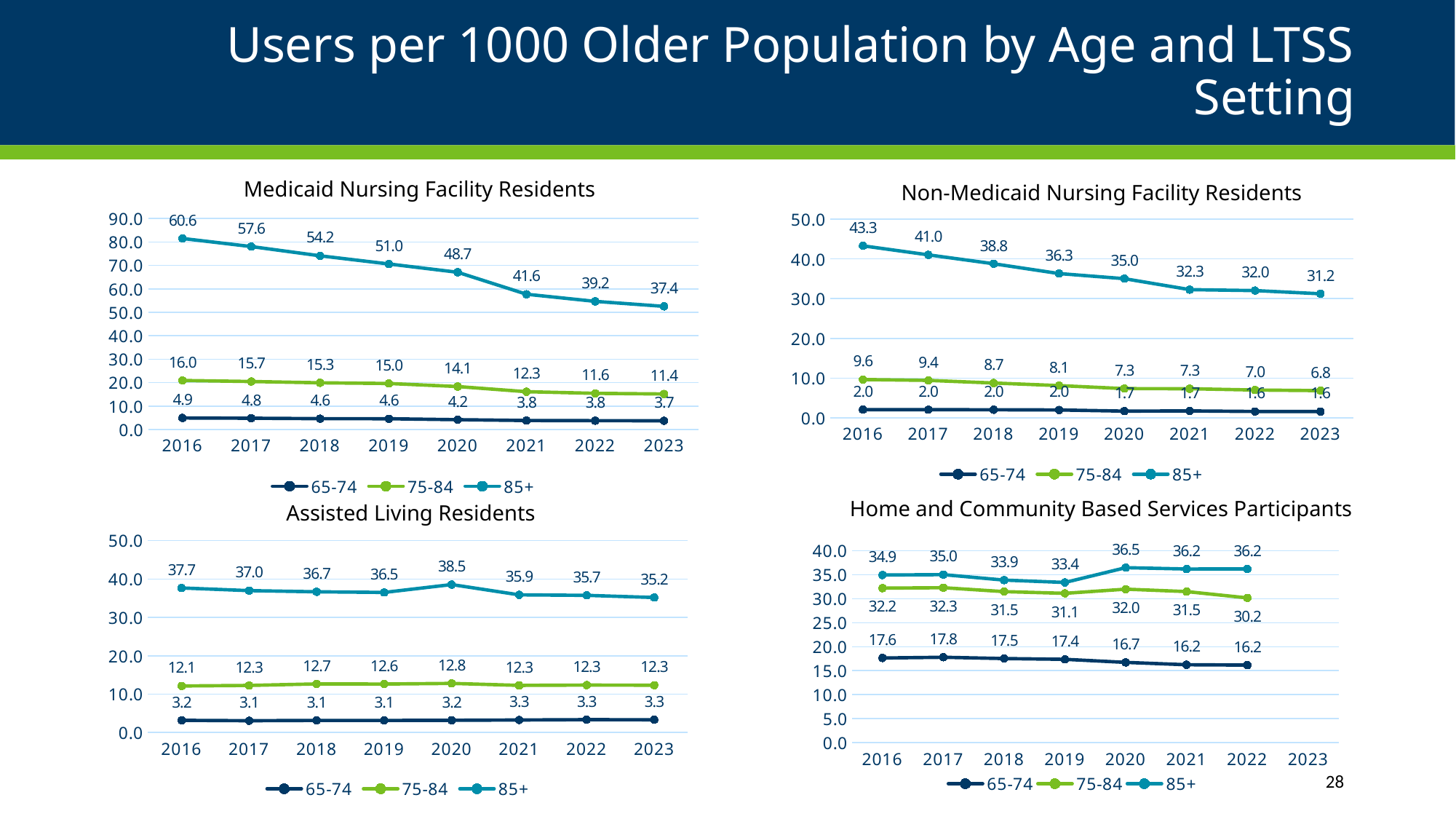
How many series does the legend list in the Assisted Living Residents chart? 3 What kind of chart is the Home and Community Based Services Participants chart? line chart In the Non-Medicaid Nursing Facility Residents chart, does the 85+ series rise or fall from 2016 to 2023? fall In the Medicaid Nursing Facility Residents chart, what is the value for the 85+ series in 2016? 60.6 In the Assisted Living Residents chart, what is the value for the 75-84 series in 2020? 12.8 In the Non-Medicaid Nursing Facility Residents chart, in which year is the 85+ series lowest? 2023 In the Assisted Living Residents chart, in which year is the 85+ series highest? 2020 In the Home and Community Based Services Participants chart, which is larger in 2022: the 85+ value or the 75-84 value? 85+ In the Medicaid Nursing Facility Residents chart, what is the difference between the 85+ values in 2016 and 2023? 23.2 In the Home and Community Based Services Participants chart, what is the value for the 65-74 series in 2017? 17.8 In the Non-Medicaid Nursing Facility Residents chart, what is the value for the 75-84 series in 2019? 8.1 In the Medicaid Nursing Facility Residents chart, what is the value for the 65-74 series in 2023? 3.7